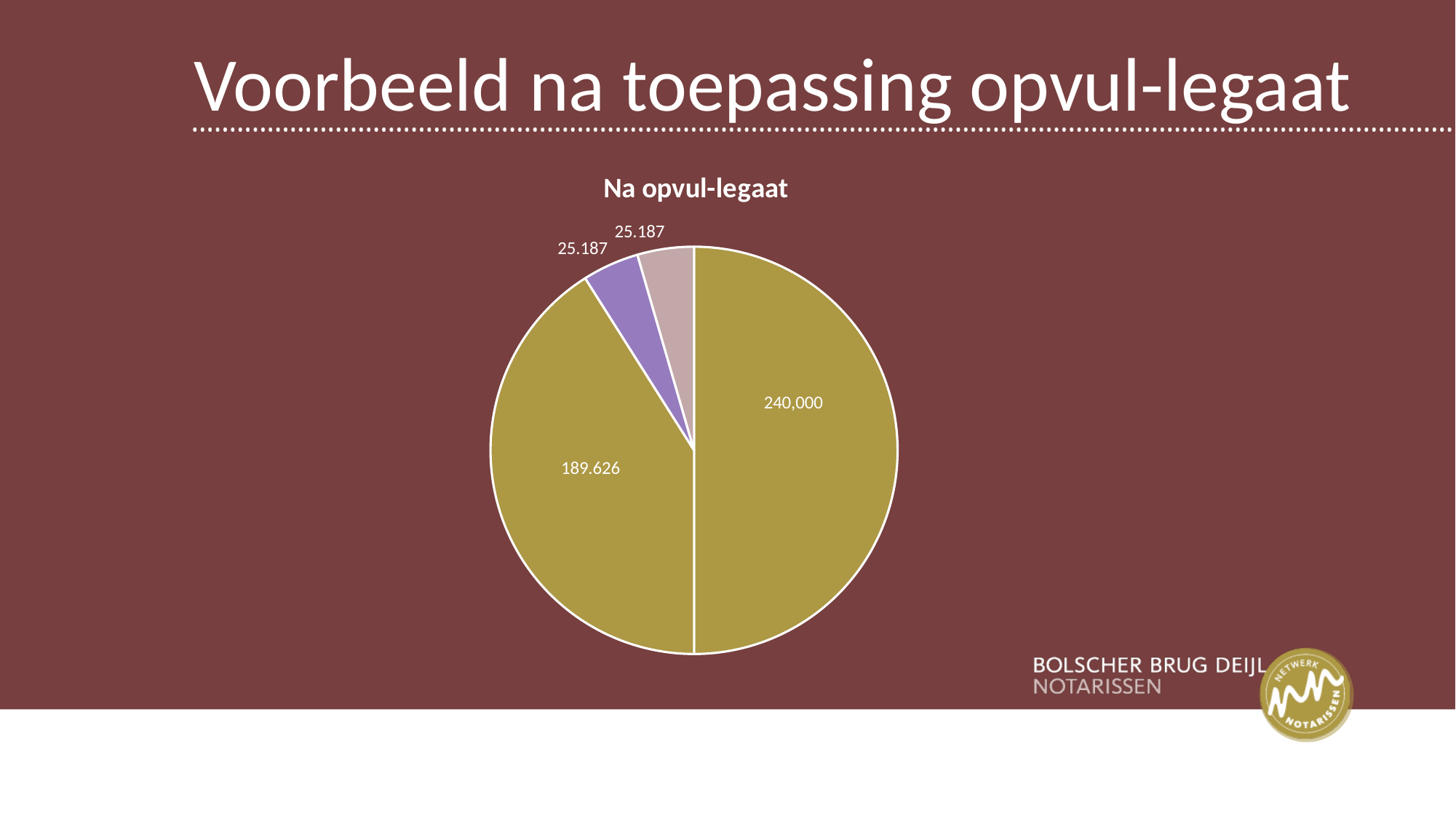
What value is labelled on the light pink slice at the top of the pie? 25.187 What value is labelled on the large slice on the left side of the pie? 189.626 How many slices does the pie chart have? 4 What colour are the two largest slices of the pie chart? olive/gold What is the value of the largest slice in the pie chart? 240,000 What is the title of the chart? Na opvul-legaat What is the smallest value labelled on the pie chart? 25.187 How many slices are labelled with the value 25.187? 2 What value is labelled on the purple slice? 25.187 What value is labelled on the large slice on the right half of the pie? 240,000 What kind of chart is shown on the slide? pie chart Which is larger, the slice labelled 240,000 or the slice labelled 189.626? 240,000